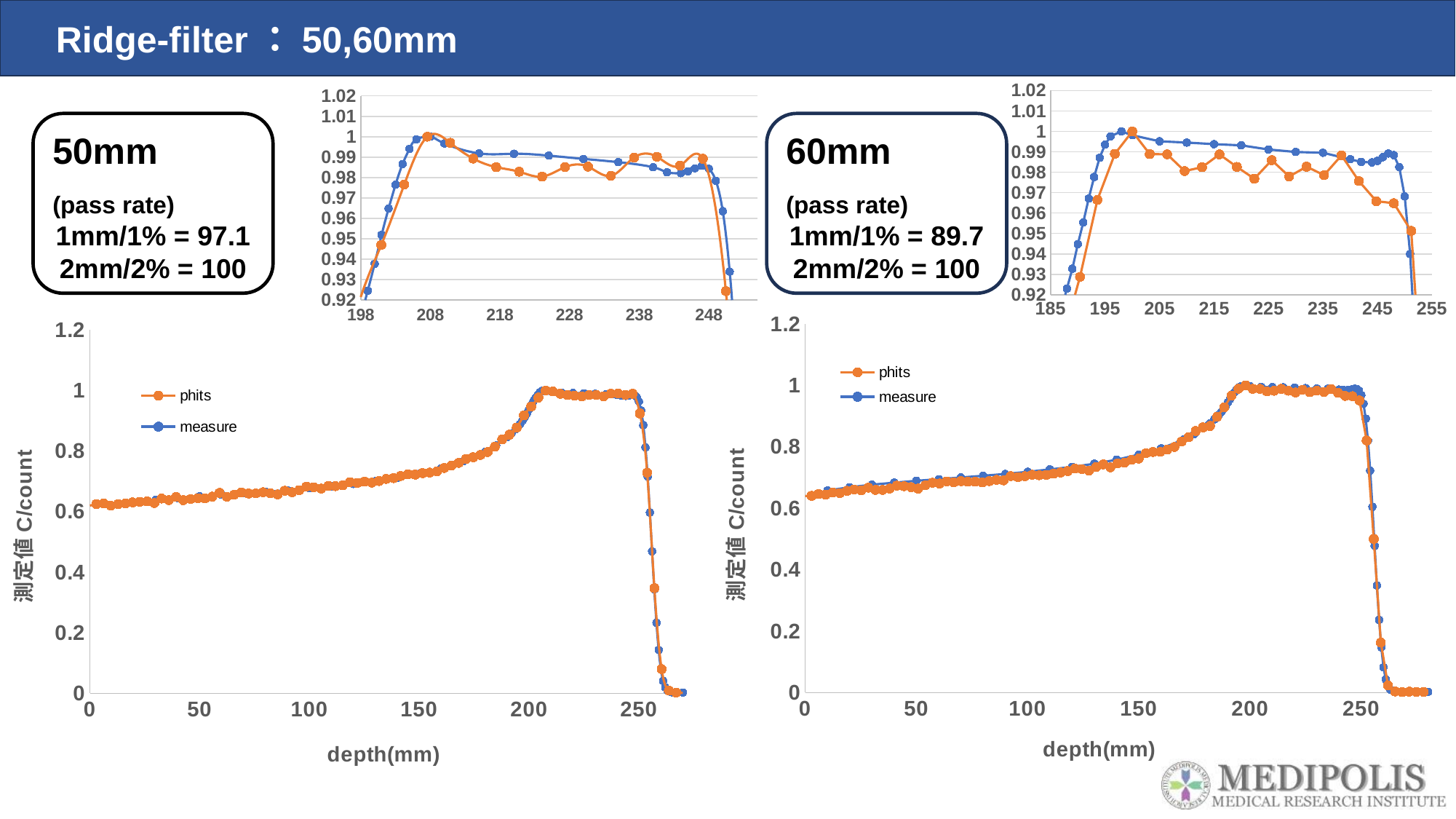
In the bottom-left chart (50mm), is the phits value at depth 0 greater or less than 0.8? less In the bottom-left chart (50mm), which is larger: the phits value at depth 0 or at depth 200? depth 200 What are the two legend entries in the bottom-right chart (60mm)? phits and measure In the bottom-left chart (50mm), do the values rise or fall as depth increases from 0 to 200? rise In the bottom-left chart (50mm), is the measure value at depth 200 greater or less than 0.8? greater In the bottom-right chart (60mm), is the phits value at depth 100 greater or less than 0.6? greater What is the x-axis label of the bottom-left chart (50mm)? depth(mm) In the bottom-right chart (60mm), do the values rise or fall as depth increases from 250 to 275? fall How many series does the legend of the bottom-left chart (50mm) list? 2 What kind of chart is the bottom-left chart (50mm)? line chart